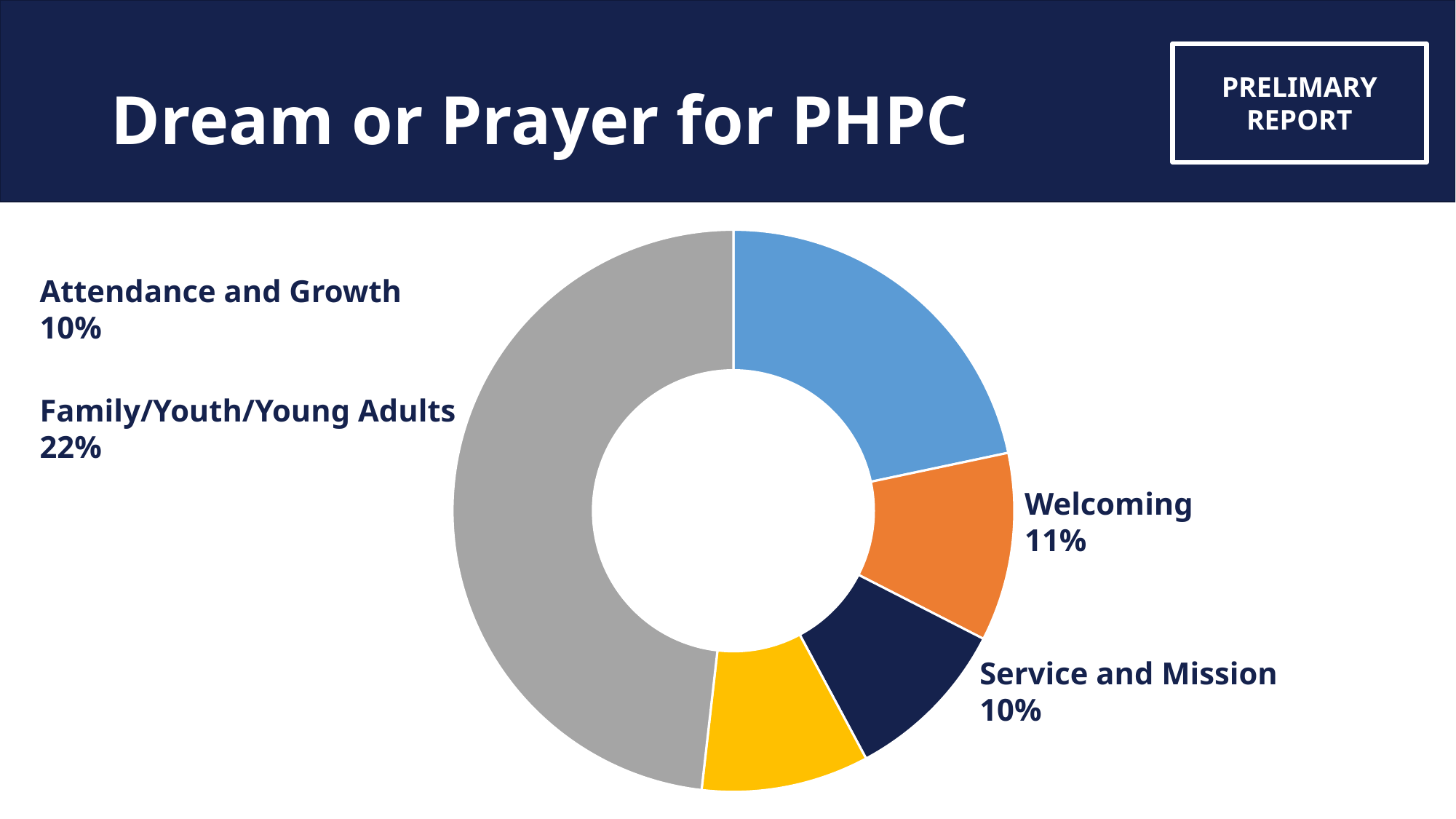
What percentage is shown for Family/Youth/Young Adults? 22% What is the difference in percentage points between Family/Youth/Young Adults and Welcoming? 11 What is the difference in percentage points between Welcoming and Service and Mission? 1 What percentage is shown for Welcoming? 11% What percentage is shown for Attendance and Growth? 10% Among the labeled categories, which has the largest share? Family/Youth/Young Adults How many slices does the chart have? 5 What percentage is shown for Service and Mission? 10% What kind of chart is shown on the slide? Doughnut chart Which is larger, the share for Family/Youth/Young Adults or the share for Attendance and Growth? Family/Youth/Young Adults Which is larger, the share for Welcoming or the share for Service and Mission? Welcoming What is the title of the slide containing the chart? Dream or Prayer for PHPC